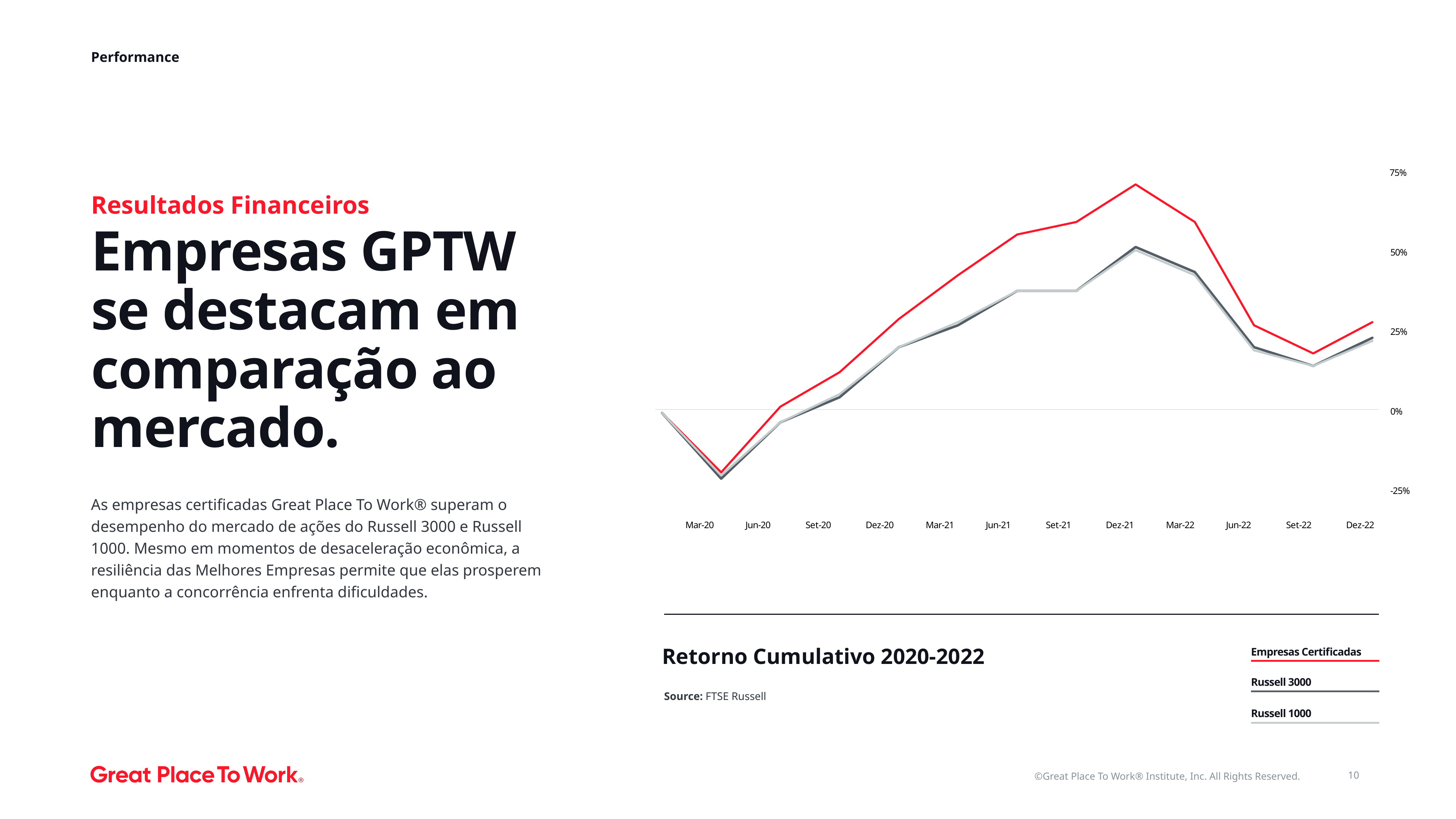
How many time points are shown along the x axis of the chart? 12 At Dez-21, which series has the higher value: Empresas Certificadas or Russell 3000? Empresas Certificadas Do the values for Empresas Certificadas rise or fall between Jun-20 and Dez-21? Rise Is the value for Russell 3000 at Set-22 greater or less than 25%? less Which series in the chart is drawn in red? Empresas Certificadas How many series does the legend of the chart list? 3 Is the value for Empresas Certificadas at Dez-21 greater or less than 50%? greater What kind of chart is shown on the slide? Line chart What is the title of the chart? Retorno Cumulativo 2020-2022 At which period does the Empresas Certificadas line reach its highest value? Dez-21 At which period does the Empresas Certificadas line reach its lowest value? Mar-20